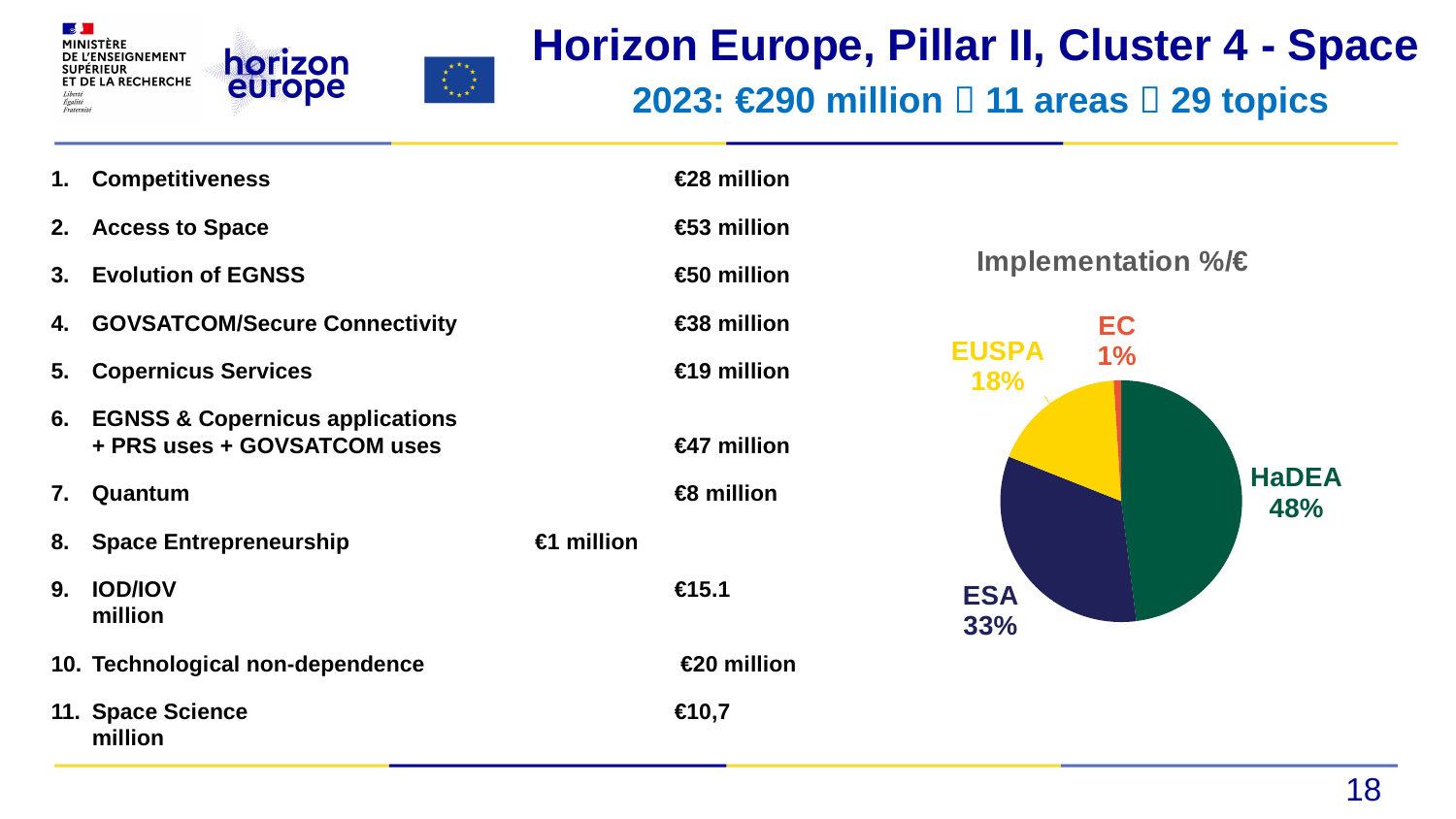
Which slice of the pie is the largest? HaDEA What share of the pie does EUSPA have? 18% What share of the pie does ESA have? 33% What kind of chart is shown on the slide? pie chart Which slice of the pie is the smallest? EC What is the difference in percentage points between the HaDEA and ESA slices? 15 Which is larger, the ESA slice or the EUSPA slice? ESA What share of the pie does HaDEA have? 48% What is the title of the chart? Implementation %/€ How many slices does the pie chart have? 4 What colour is the HaDEA slice of the pie? green